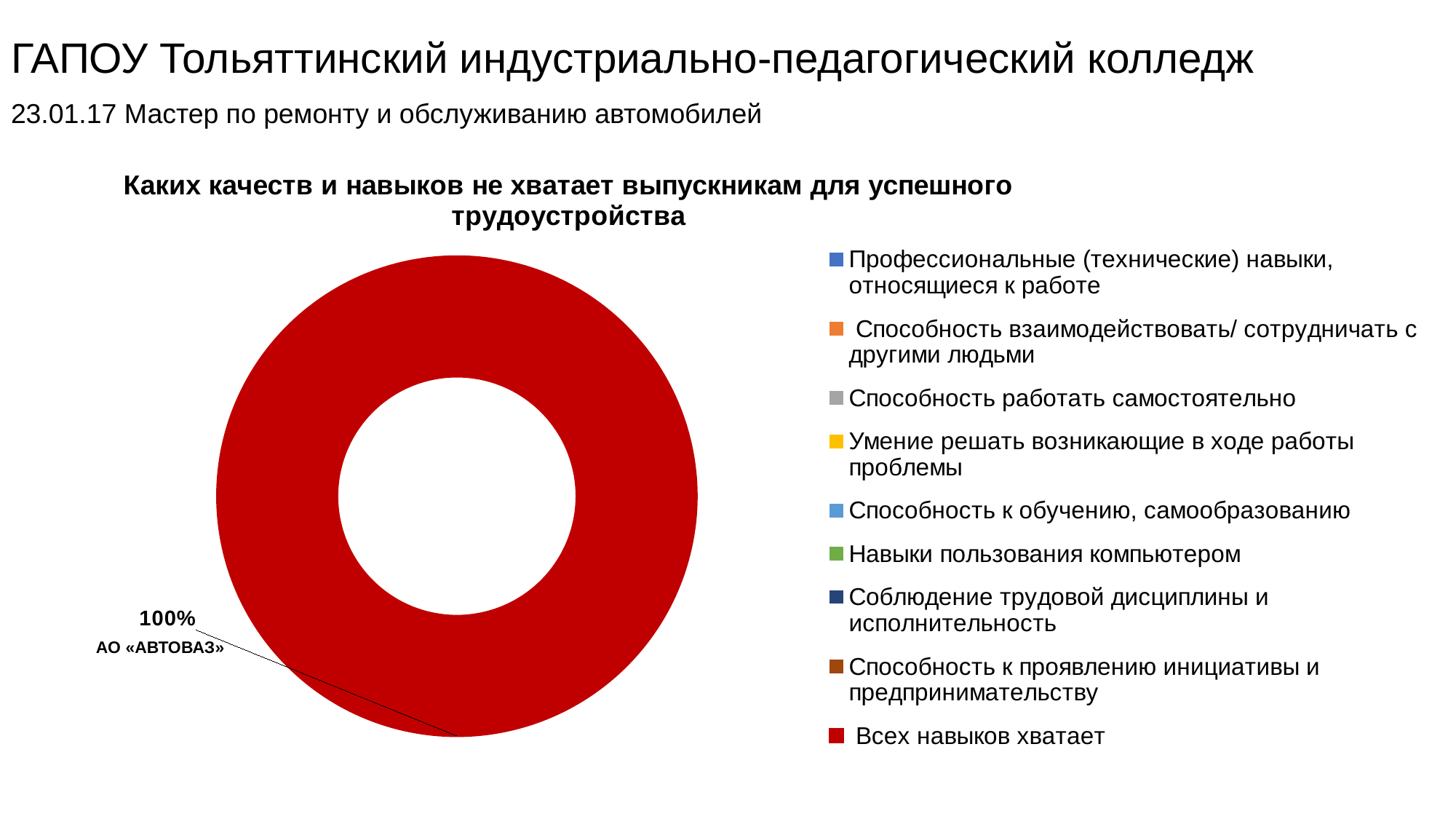
What is the title of the chart? Каких качеств и навыков не хватает выпускникам для успешного трудоустройства Which is larger: the share for 'Всех навыков хватает' or the share for 'Навыки пользования компьютером'? Всех навыков хватает What colour is the slice representing 'Всех навыков хватает'? Red How many entries does the chart legend list? 9 What percentage is shown on the data label of the chart? 100% What share of the chart does the category 'Всех навыков хватает' take? 100% How many slices are visibly plotted in the chart? 1 Which organisation is named in the data label next to the 100% value? АО «АВТОВАЗ» Is the value for 'Всех навыков хватает' greater or less than 50%? greater Which legend category does the red slice that fills the whole chart correspond to? Всех навыков хватает What kind of chart is shown on the slide? Doughnut (pie) chart